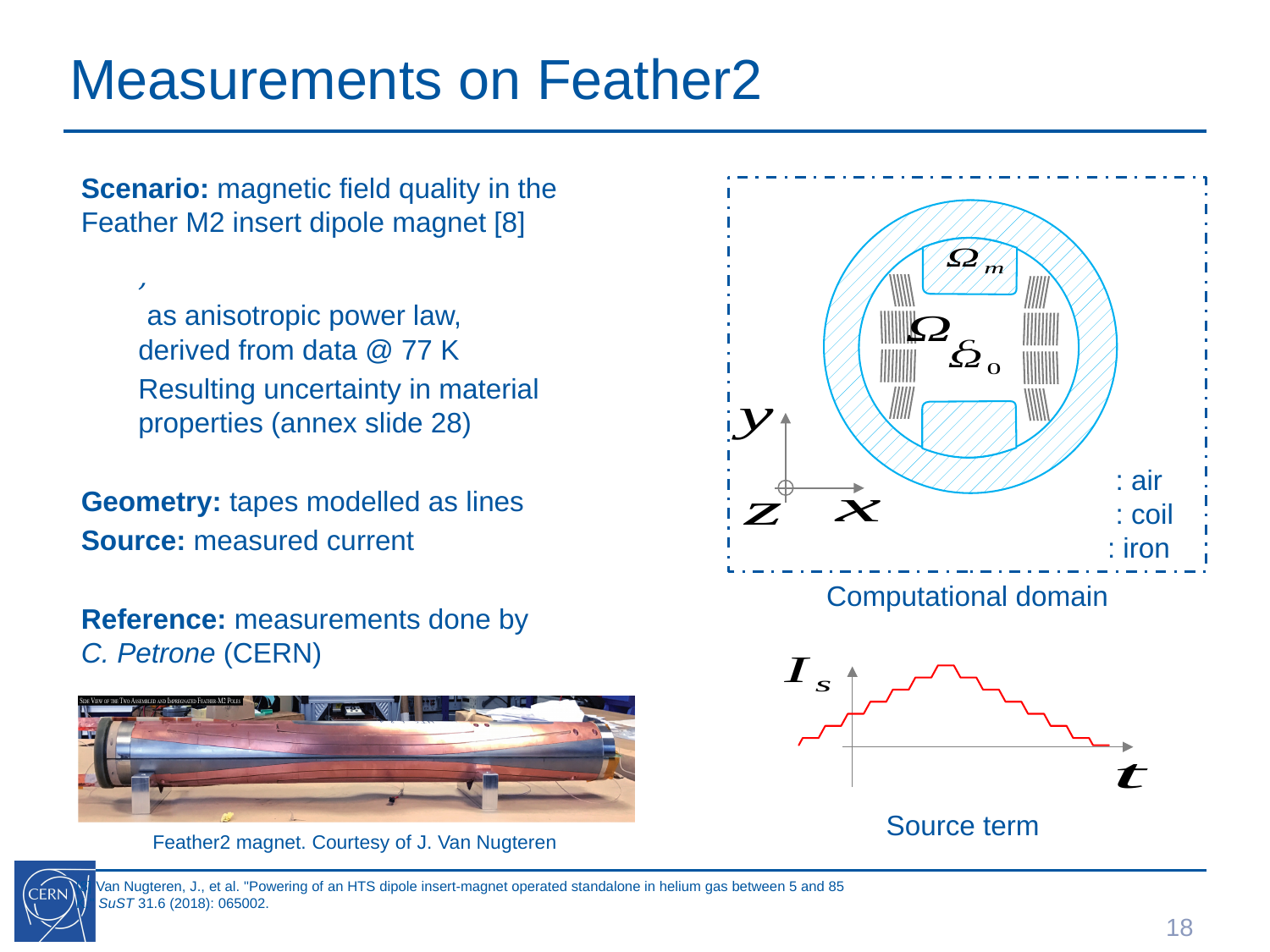
In the 'Source term' plot, does the plotted current rise or fall over the first half of the time axis? rise In the 'Source term' plot, what is the label on the vertical axis? I_s What kind of chart is the 'Source term' plot? line chart In the 'Source term' plot, does the plotted current rise or fall over the second half of the time axis? fall In the 'Source term' plot, what is the label on the horizontal axis? t